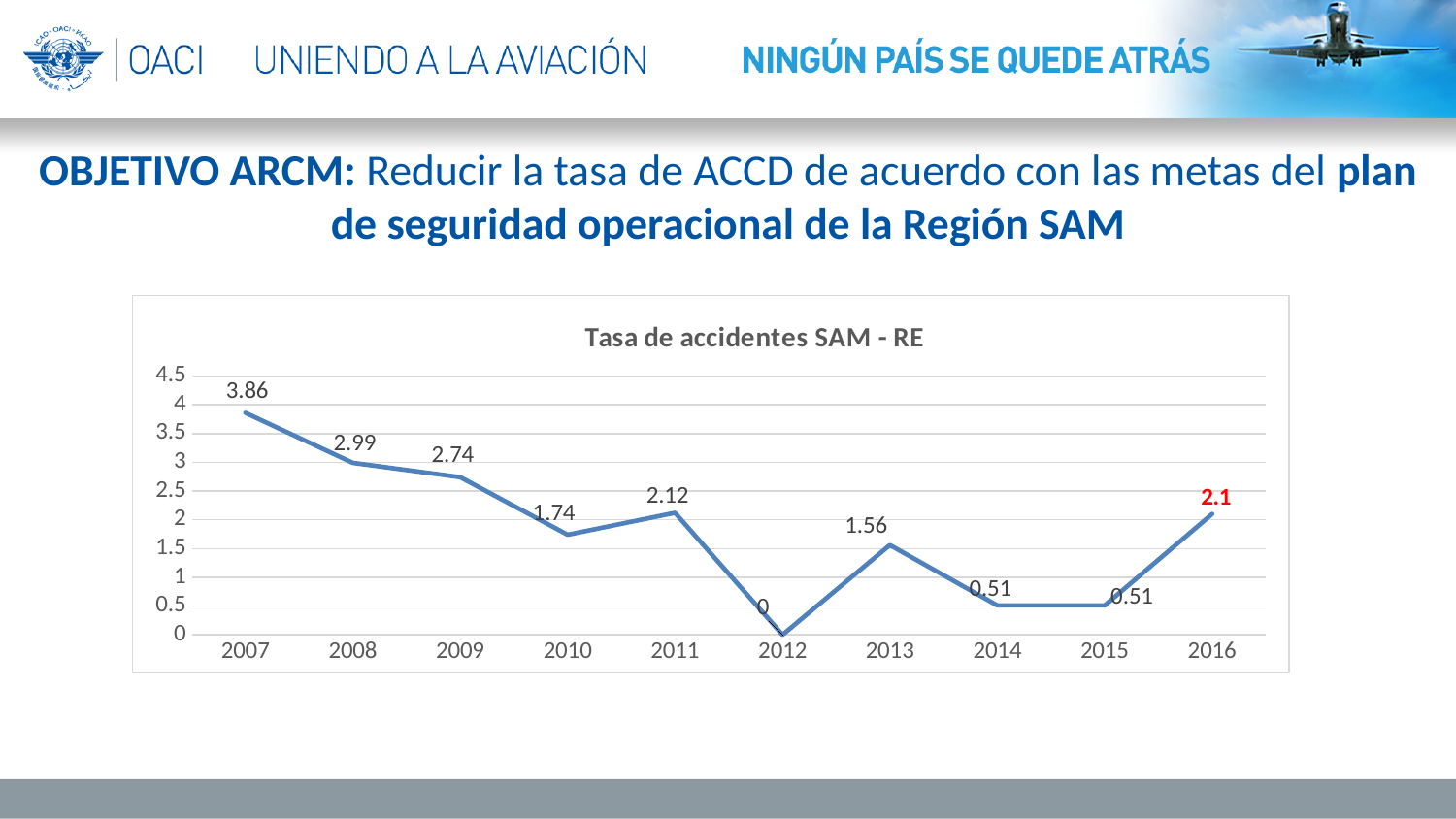
What is the difference between the accident rates for 2007 and 2008? 0.87 Which year has the lowest accident rate? 2012 Which data label on the chart is shown in red? 2.1 (2016) What is the accident rate for 2007? 3.86 How many years are plotted on the chart? 10 What kind of chart is shown? Line chart Which year has the highest accident rate? 2007 What is the title of the chart? Tasa de accidentes SAM - RE Does the accident rate rise or fall from 2007 to 2010? Fall Which year has a higher accident rate, 2011 or 2013? 2011 What is the accident rate for 2013? 1.56 What is the accident rate for 2016? 2.1